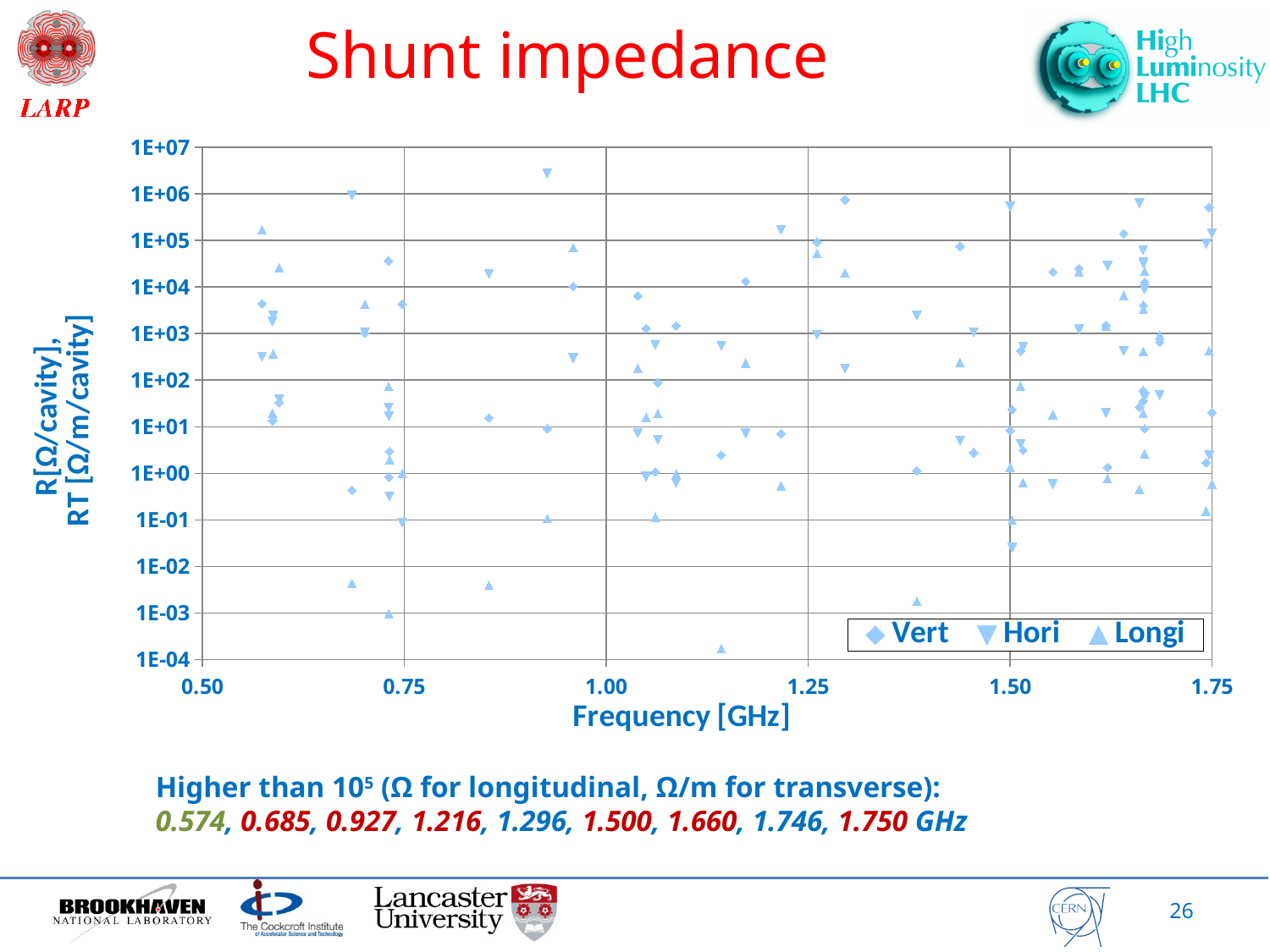
Which series contains the highest plotted point on the chart? Hori Is the Vert value plotted near 1.30 GHz greater or less than 1E+05? greater What is the label of the x axis? Frequency [GHz] What are the series names listed in the legend? Vert, Hori, Longi Is the highest plotted value on the chart greater or less than 1E+06? greater Is the lowest plotted value on the chart greater or less than 1E-03? less What kind of chart is shown on the slide? Scatter chart Which series contains the lowest plotted point on the chart? Longi How many series does the legend list? 3